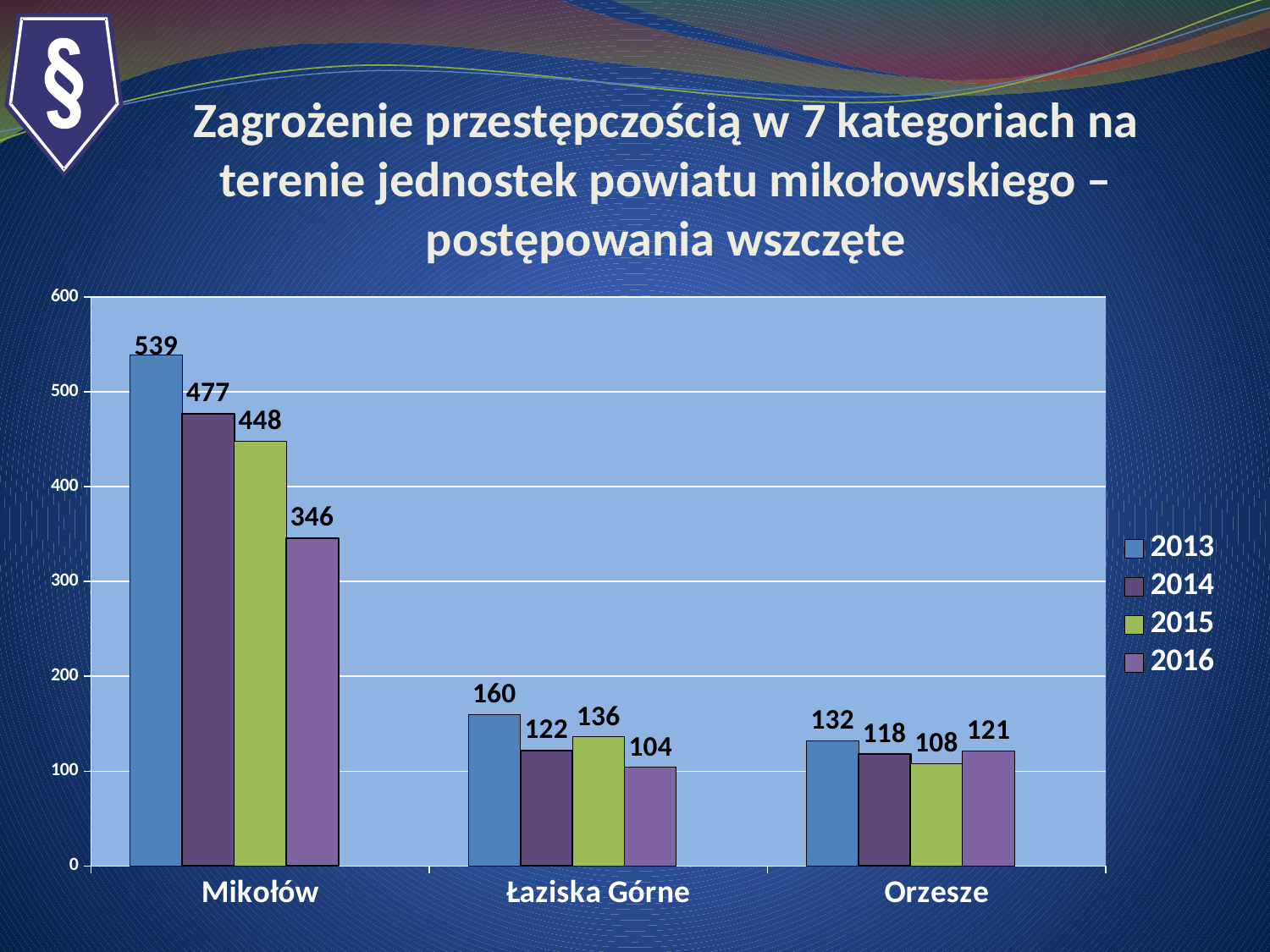
How many series does the legend list? 4 Is the 2014 value for Mikołów greater or less than 400? greater Which year has the lowest value for Mikołów? 2016 What is the value for Orzesze in 2015? 108 What is the value for Łaziska Górne in 2016? 104 What is the value for Mikołów in 2013? 539 How many categories are shown on the x axis? 3 Which is larger: the 2015 value for Łaziska Górne or the 2015 value for Orzesze? Łaziska Górne What kind of chart is shown on the slide? bar chart What is the difference between the 2013 and 2016 values for Mikołów? 193 Do the values for Mikołów rise or fall from 2013 to 2016? fall Which category has the highest value in 2014? Mikołów